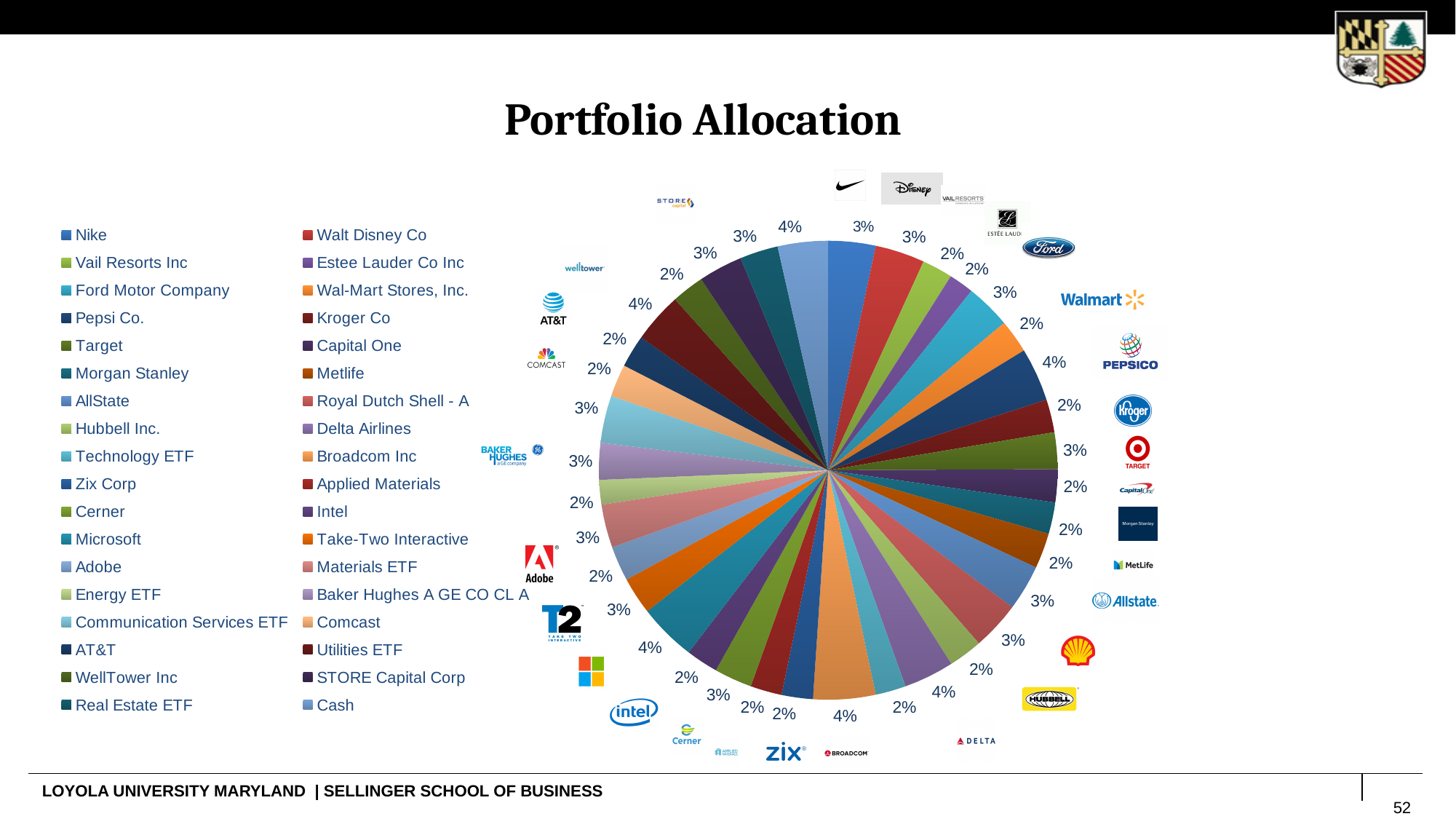
What share of the portfolio is allocated to Nike? 3% What share of the portfolio is allocated to Target? 3% What share of the portfolio is allocated to Pepsi Co.? 4% What is the title of the chart? Portfolio Allocation Which has the larger allocation, Pepsi Co. or Wal-Mart Stores, Inc.? Pepsi Co. What is the difference between the allocations to Pepsi Co. and Wal-Mart Stores, Inc.? 2% What kind of chart is shown on the slide? pie chart How many holdings does the legend of the pie chart list? 36 Which holding is listed last in the legend? Cash